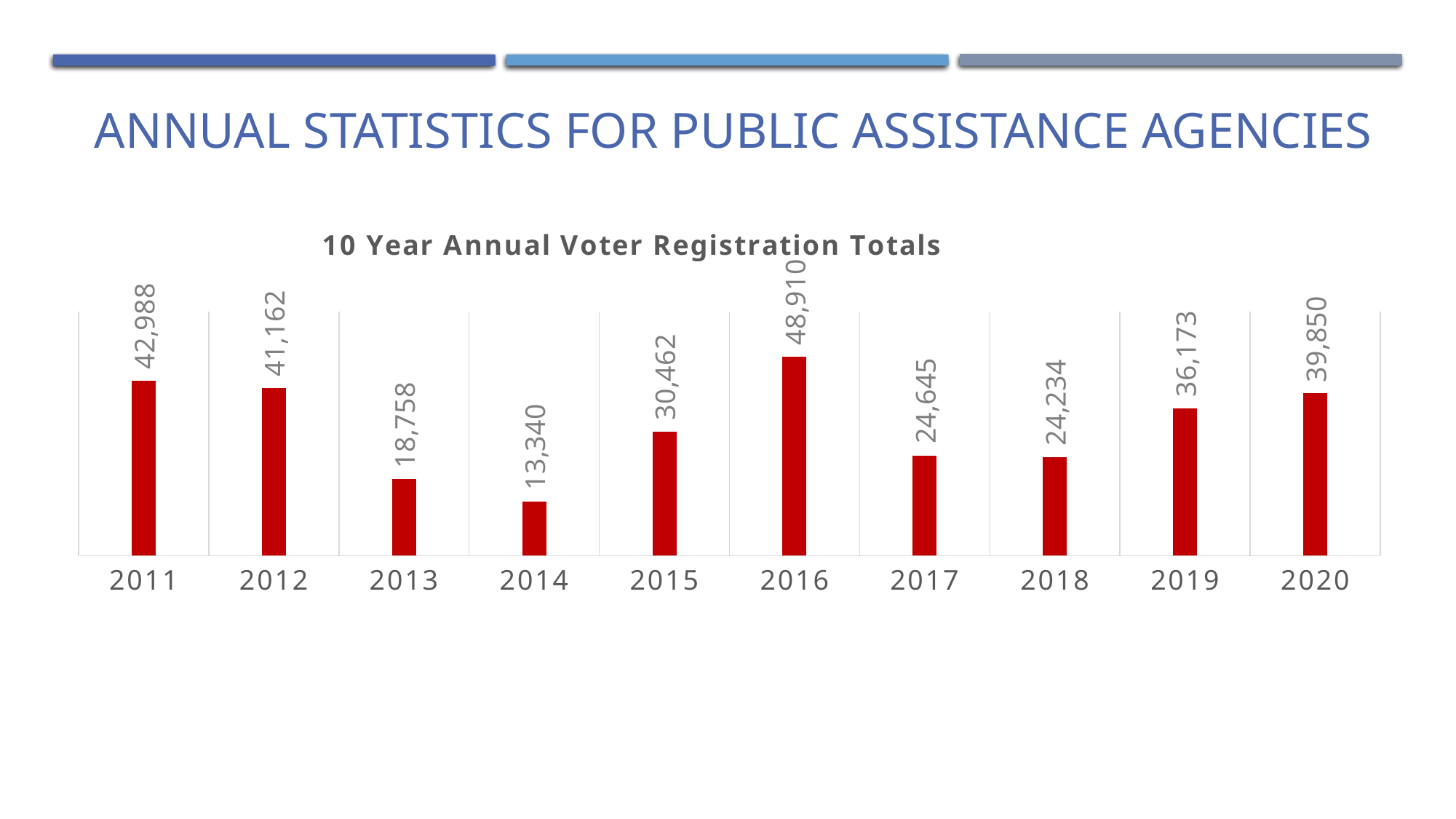
What is the voter registration total for 2019? 36,173 Which year has the highest voter registration total? 2016 Which year has a larger voter registration total, 2015 or 2020? 2020 What kind of chart is shown on the slide? Bar chart What is the voter registration total for 2014? 13,340 What is the title of the chart? 10 Year Annual Voter Registration Totals Which year has the lowest voter registration total? 2014 What is the voter registration total for 2016? 48,910 How many years are shown on the chart? 10 What is the difference between the 2016 and 2014 voter registration totals? 35,570 What is the difference between the 2011 and 2012 voter registration totals? 1,826 Do the voter registration totals rise or fall from 2016 to 2018? Fall